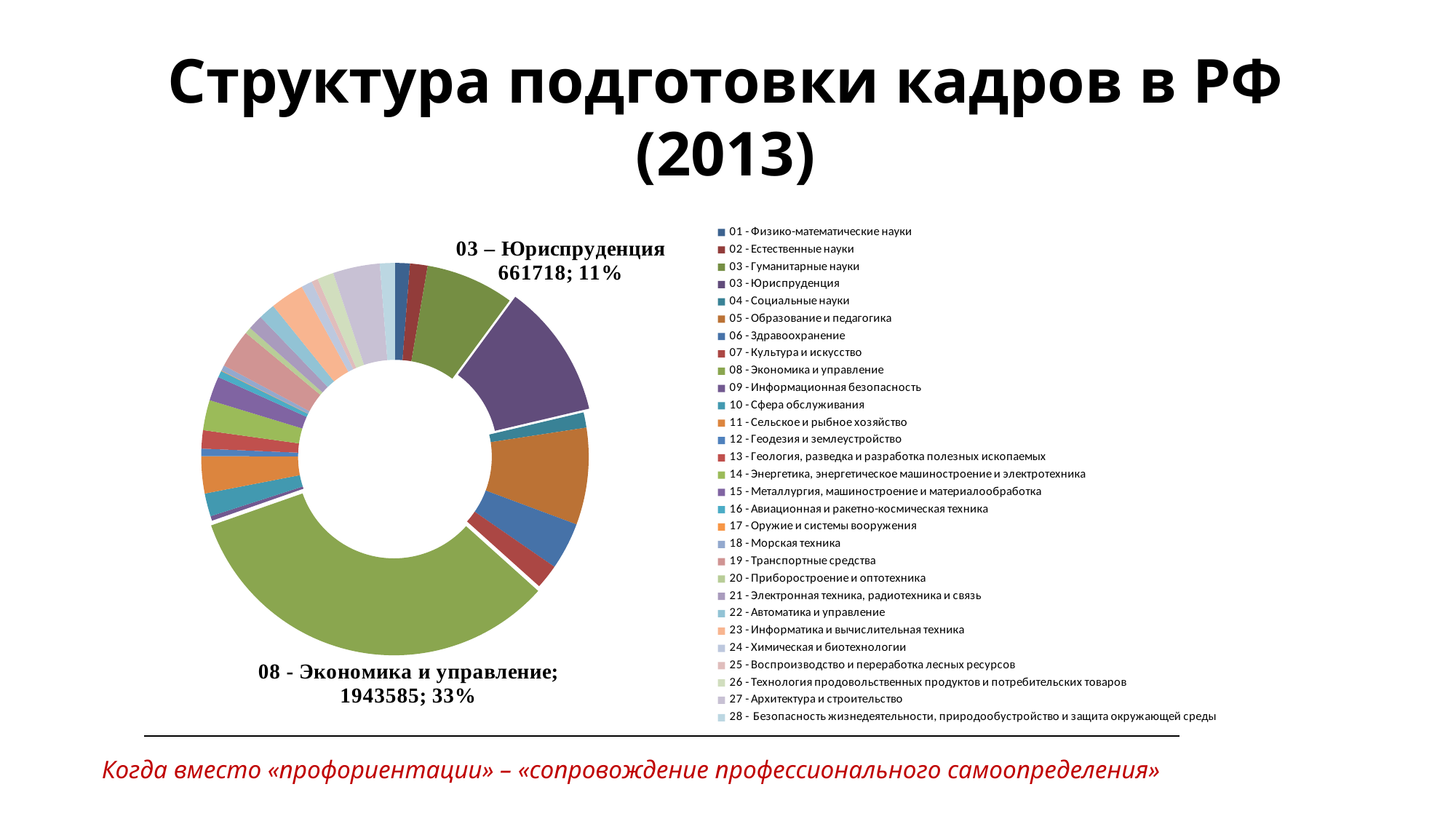
Which category has the largest slice in the chart? 08 - Экономика и управление What value is shown for the slice "08 - Экономика и управление"? 1943585 Which legend entry is listed last in the chart legend? 28 - Безопасность жизнедеятельности, природообустройство и защита окружающей среды How many categories are listed in the chart legend? 29 What kind of chart is shown on the slide? Pie (doughnut) chart What is the title of the chart slide? Структура подготовки кадров в РФ (2013) What colour is the slice for "08 - Экономика и управление"? Green What is the difference between the values for "08 - Экономика и управление" and "03 – Юриспруденция"? 1281867 What share of the pie does "03 – Юриспруденция" represent? 11% Which is larger: the slice for "08 - Экономика и управление" or the slice for "03 – Юриспруденция"? 08 - Экономика и управление What value is shown for the slice "03 – Юриспруденция"? 661718 What share of the pie does "08 - Экономика и управление" represent? 33%